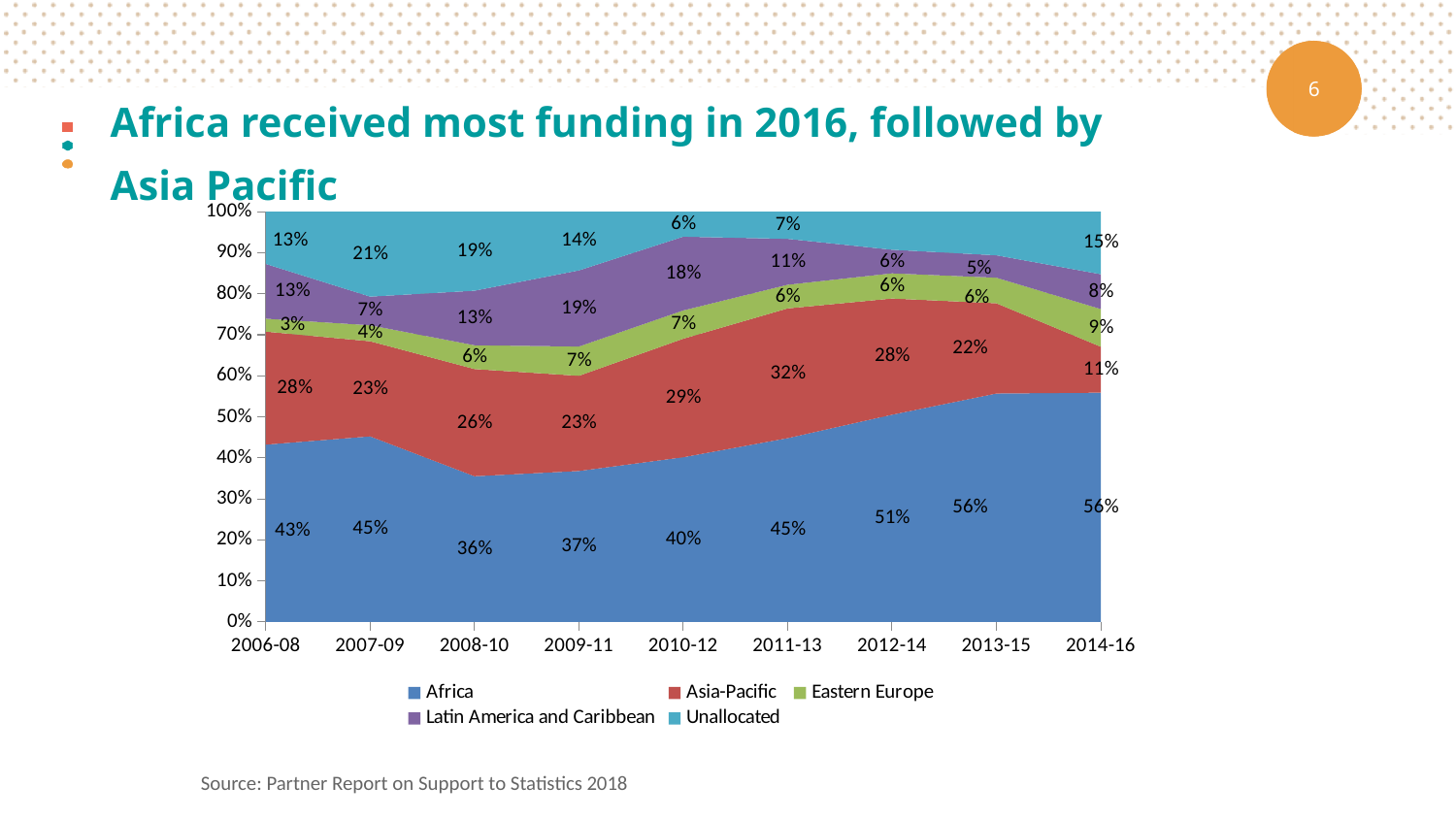
What share of funding did Africa receive in 2014-16? 56% How many time periods are shown on the x axis? 9 What was the Eastern Europe share in 2006-08? 3% By how many percentage points did Africa's share in 2014-16 exceed its share in 2006-08? 13 percentage points What share did Latin America and Caribbean receive in 2009-11? 19% What share of funding did Asia-Pacific receive in 2011-13? 32% How many series does the legend list? 5 In which period was Africa's share lowest? 2008-10 What was the Unallocated share in 2007-09? 21% In 2010-12, which had the larger share: Asia-Pacific or Latin America and Caribbean? Asia-Pacific In which period was Asia-Pacific's share highest? 2011-13 What kind of chart is shown on the slide? Stacked area chart